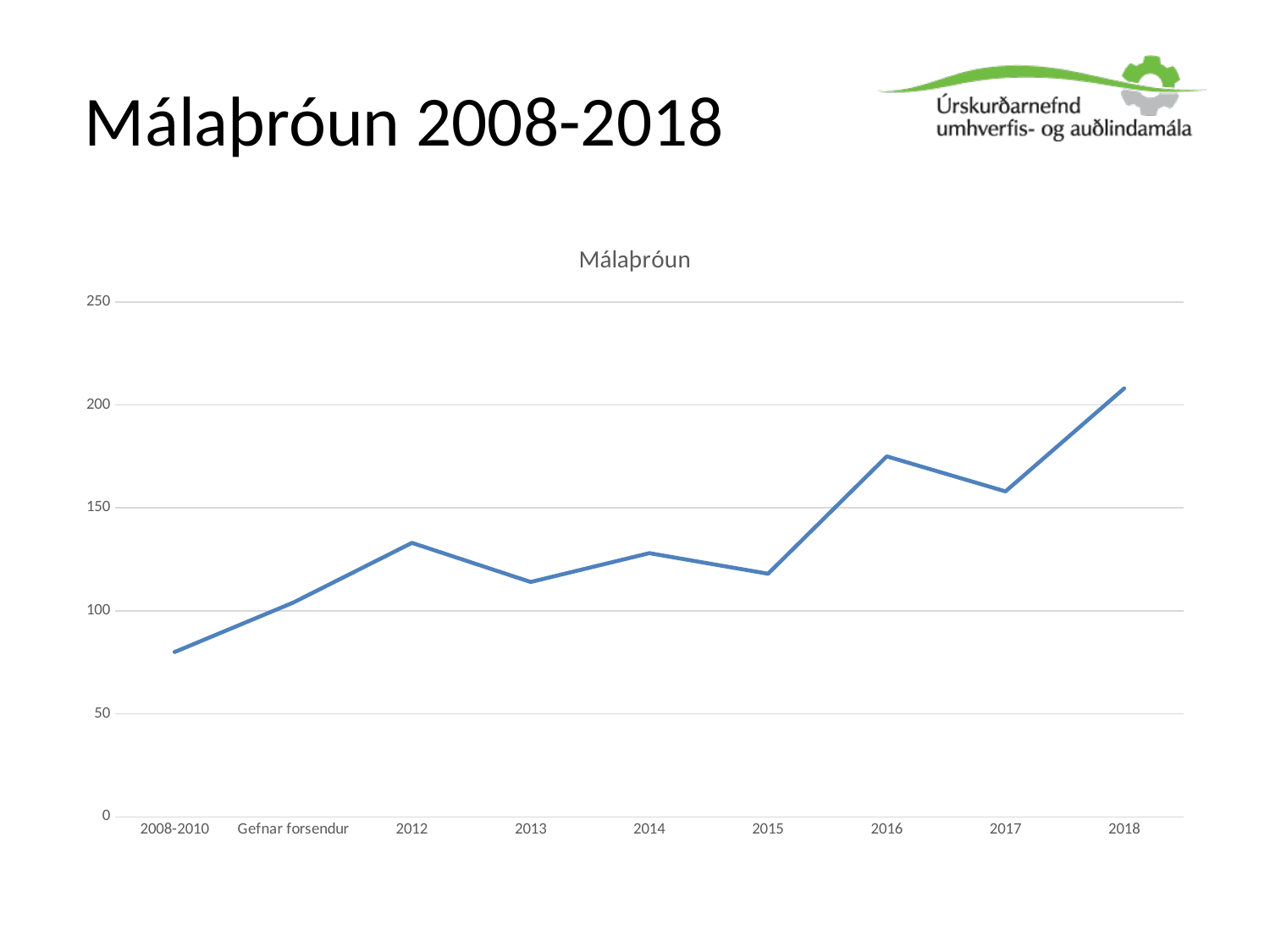
Is the value for 2013 greater or less than 150? less Which category has the lowest value in the chart? 2008-2010 How many points are plotted along the x axis of the chart? 9 What kind of chart is shown on the slide? Line chart Which is larger, the value for 2016 or the value for 2017? 2016 Which category has the highest value in the chart? 2018 Which is larger, the value for 2012 or the value for 2013? 2012 Overall, do the values rise or fall from 2008-2010 to 2018? Rise Is the value for 2016 greater or less than 150? greater What is the title of the chart? Málaþróun Is the value for 2008-2010 greater or less than 100? less